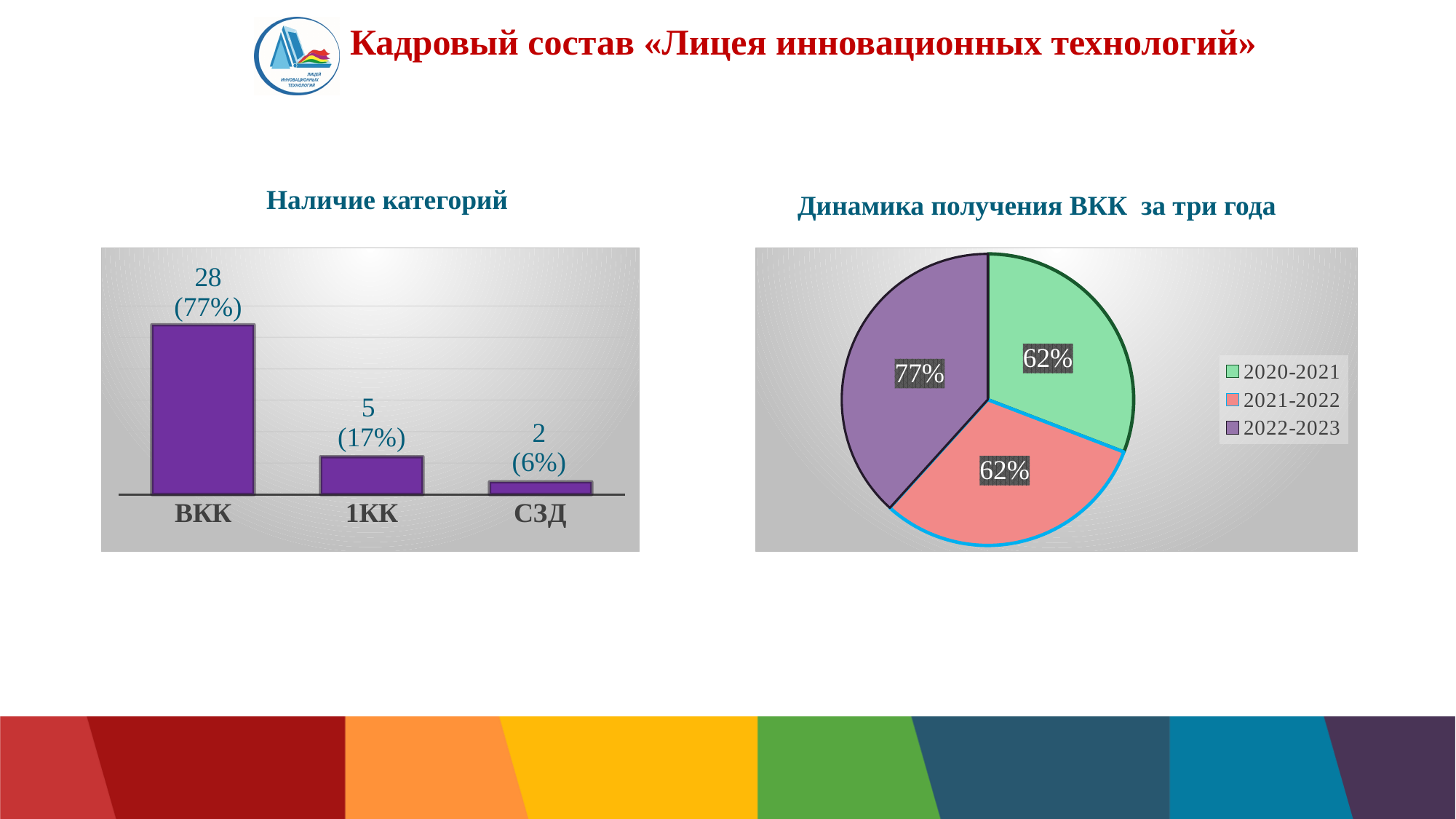
What type of chart is 'Динамика получения ВКК за три года'? pie chart What type of chart is 'Наличие категорий'? bar chart In the 'Наличие категорий' chart, what is the value for ВКК? 28 In the 'Наличие категорий' chart, what is the value for СЗД? 2 In the 'Наличие категорий' chart, what is the difference between the values for ВКК and 1КК? 23 In the 'Наличие категорий' chart, which category has the highest value? ВКК In the 'Динамика получения ВКК за три года' chart, what value is shown for 2022-2023? 77% How many entries does the legend of the 'Динамика получения ВКК за три года' chart list? 3 In the 'Наличие категорий' chart, how many categories are shown? 3 In the 'Наличие категорий' chart, which category has the lowest value? СЗД In the 'Динамика получения ВКК за три года' chart, what value is shown for 2020-2021? 62% In the 'Наличие категорий' chart, what percentage is shown for 1КК? 17%